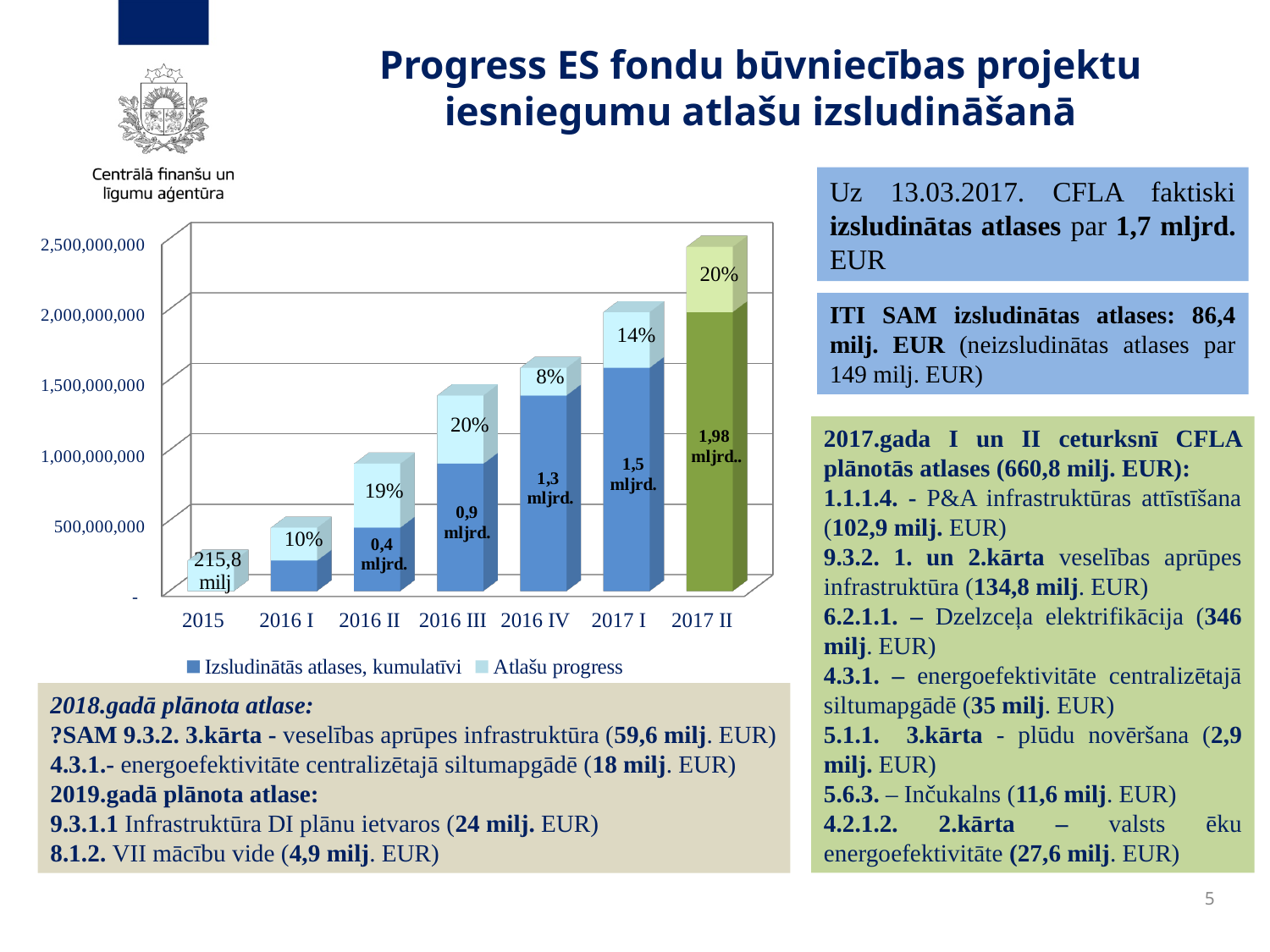
What kind of chart is shown on the slide? bar chart What percentage is labelled on the light blue segment of the 2016 II bar? 19% What value is labelled on the 2015 bar? 215,8 milj What value is labelled on the lower segment of the 2017 II bar? 1,98 mljrd.. Is the total height of the 2017 II bar greater or less than 2,000,000,000? greater Which category has the shortest bar in the chart? 2015 Which category has the tallest bar in the chart? 2017 II What value is labelled on the dark blue segment of the 2016 III bar? 0,9 mljrd. What percentage is labelled on the light blue segment of the 2016 IV bar? 8% How many series does the chart legend list? 2 Do the bar heights rise or fall from 2015 to 2017 II? rise How many categories are shown on the x axis of the chart? 7